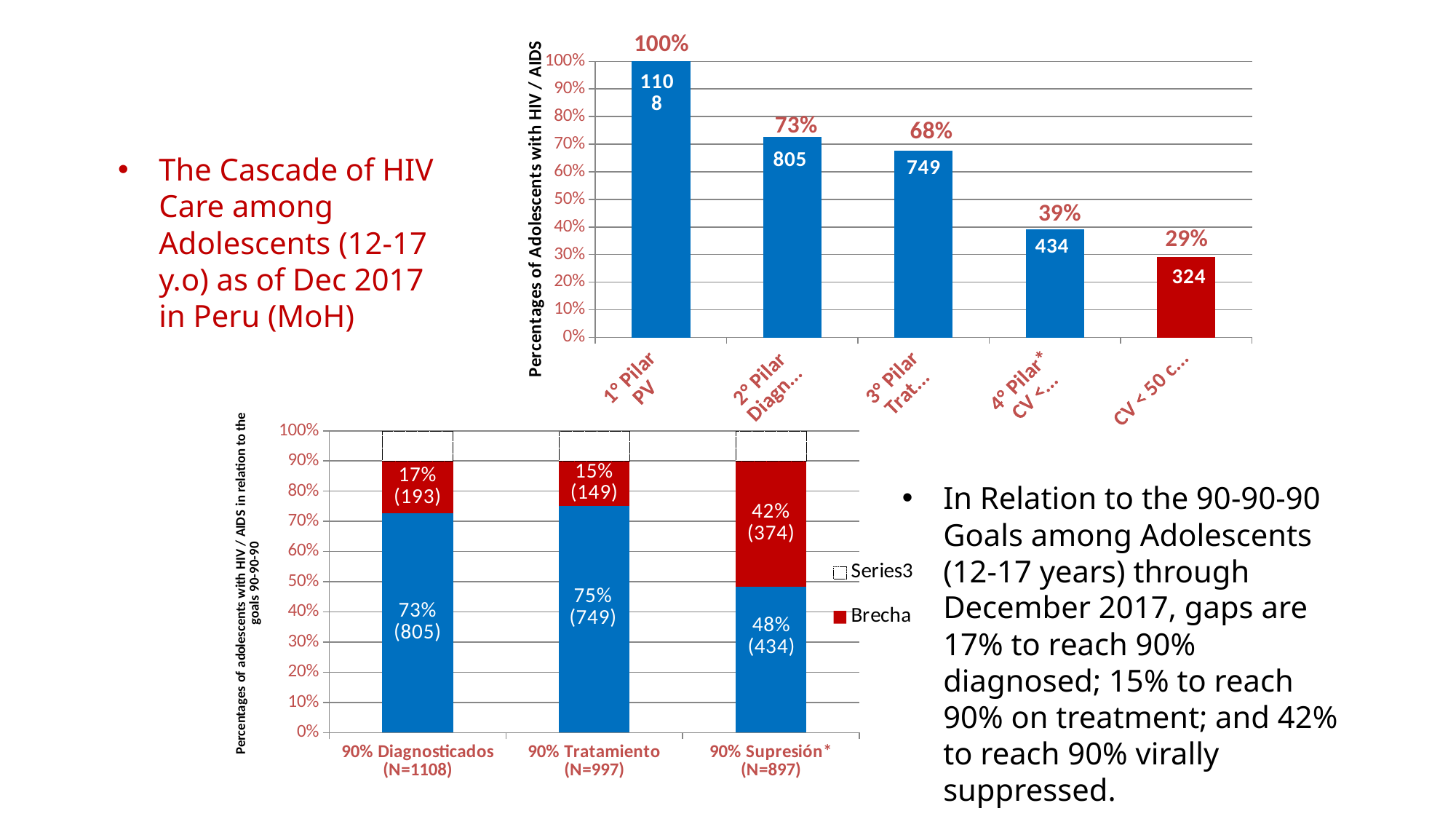
In the bottom-left 90-90-90 chart, what is the Brecha (gap) value for 90% Supresión*? 42% (374) In the bottom-left 90-90-90 chart, how many entries does the legend list? 2 What type of chart is the bottom-left 90-90-90 chart? stacked bar chart In the top-right cascade chart, what percentage is shown for the CV < 50 bar? 29% In the bottom-left 90-90-90 chart, what is the blue value for 90% Tratamiento? 75% (749) In the bottom-left 90-90-90 chart, which category has the largest Brecha (red) segment? 90% Supresión* In the top-right cascade chart, which category has the lowest percentage? CV < 50 In the top-right cascade chart, what is the difference in percentage points between the 2° Pilar bar and the 4° Pilar bar? 34 In the top-right cascade chart, how many bars are plotted? 5 In the top-right cascade chart, do the values rise or fall from left to right along the x axis? fall In the top-right cascade chart, what count is printed inside the 3° Pilar bar? 749 In the top-right cascade chart, what percentage is shown for the 1° Pilar PV bar? 100%